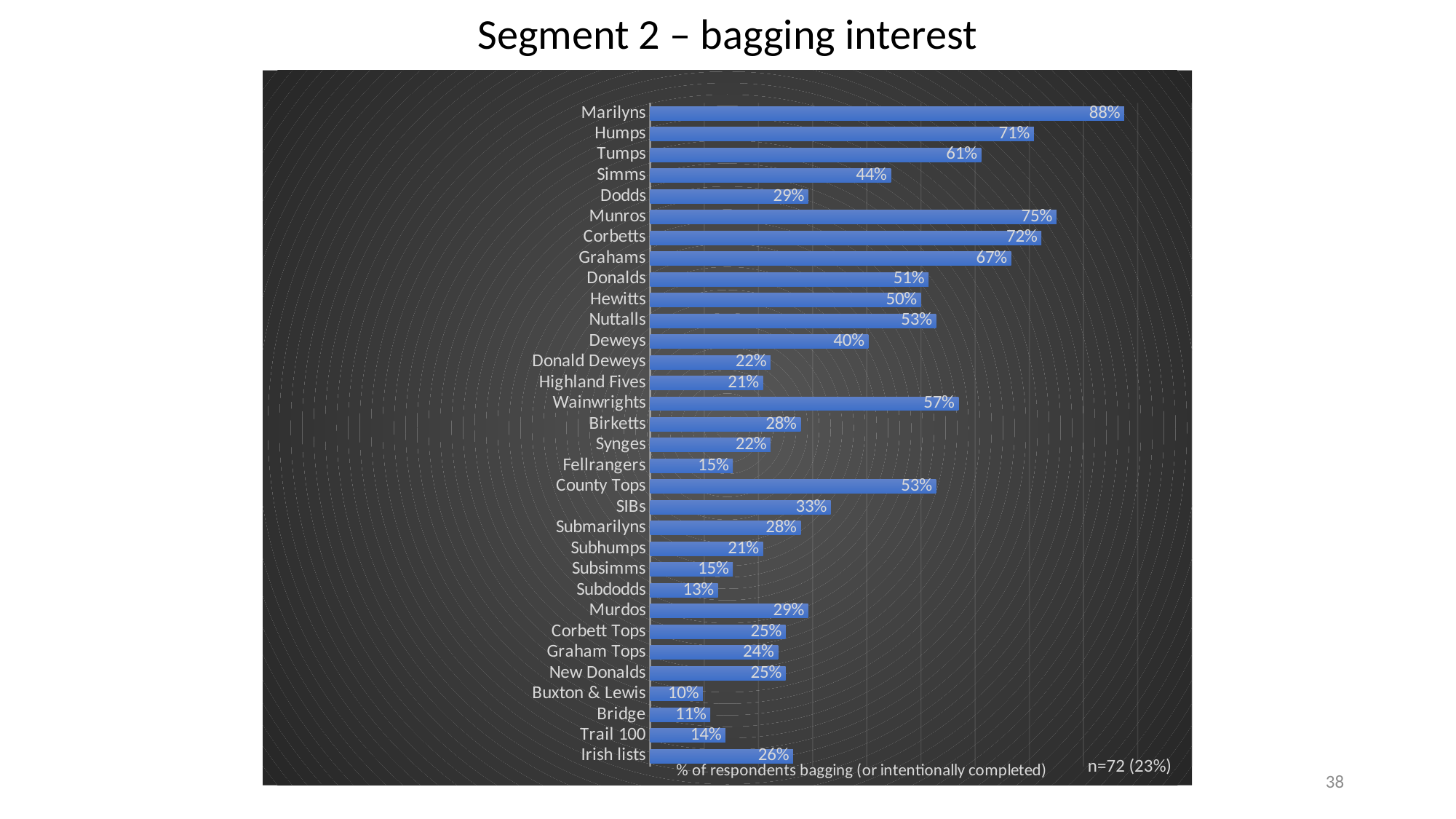
Which list has the lowest percentage of respondents bagging it? Buxton & Lewis What is the sample size noted on the chart? n=72 (23%) What percentage of respondents are bagging Marilyns? 88% What is the difference between the percentages for Munros and Corbetts? 3% Which has a higher value, SIBs or Submarilyns? SIBs What is the difference between the values for Humps and Dodds? 42% How many lists (categories) are shown in the chart? 32 What type of chart is shown on the slide? Bar chart What percentage is shown for Subdodds? 13% Which has a higher value, Grahams or Donalds? Grahams Which list has the highest percentage of respondents bagging it? Marilyns What is the value shown for Wainwrights? 57%